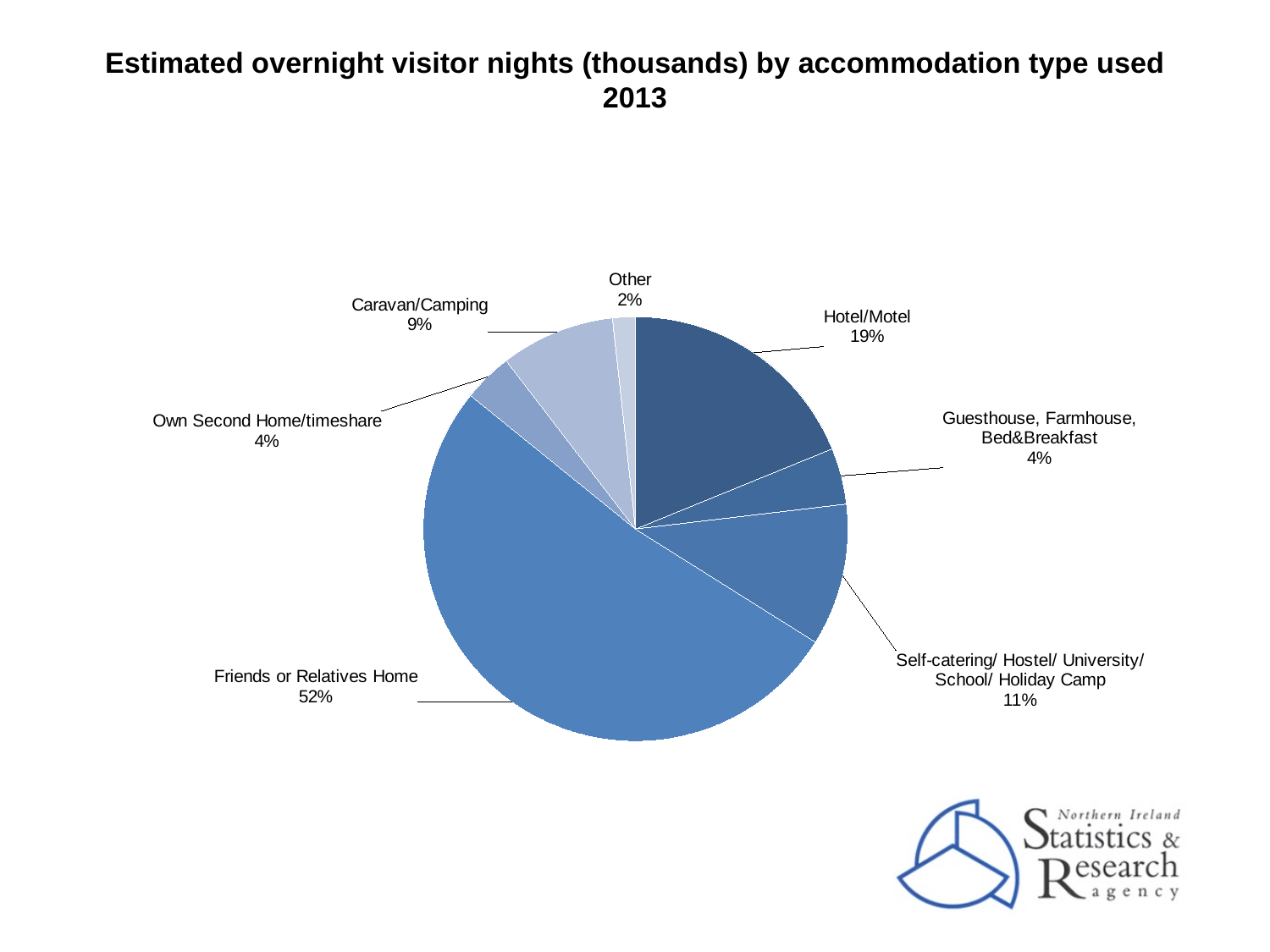
What share of overnight visitor nights is for Other? 2% What is the difference in percentage points between the Hotel/Motel share and the Caravan/Camping share? 10 What kind of chart is shown on the slide? Pie chart Which accommodation type has the smallest share of overnight visitor nights? Other How many accommodation types are shown in the pie chart? 7 What is the title of the chart? Estimated overnight visitor nights (thousands) by accommodation type used 2013 Which accommodation type has the largest share of overnight visitor nights? Friends or Relatives Home What share of overnight visitor nights is for Self-catering/ Hostel/ University/ School/ Holiday Camp? 11% What share of overnight visitor nights is for Hotel/Motel? 19% Which has a larger share, Hotel/Motel or Self-catering/ Hostel/ University/ School/ Holiday Camp? Hotel/Motel